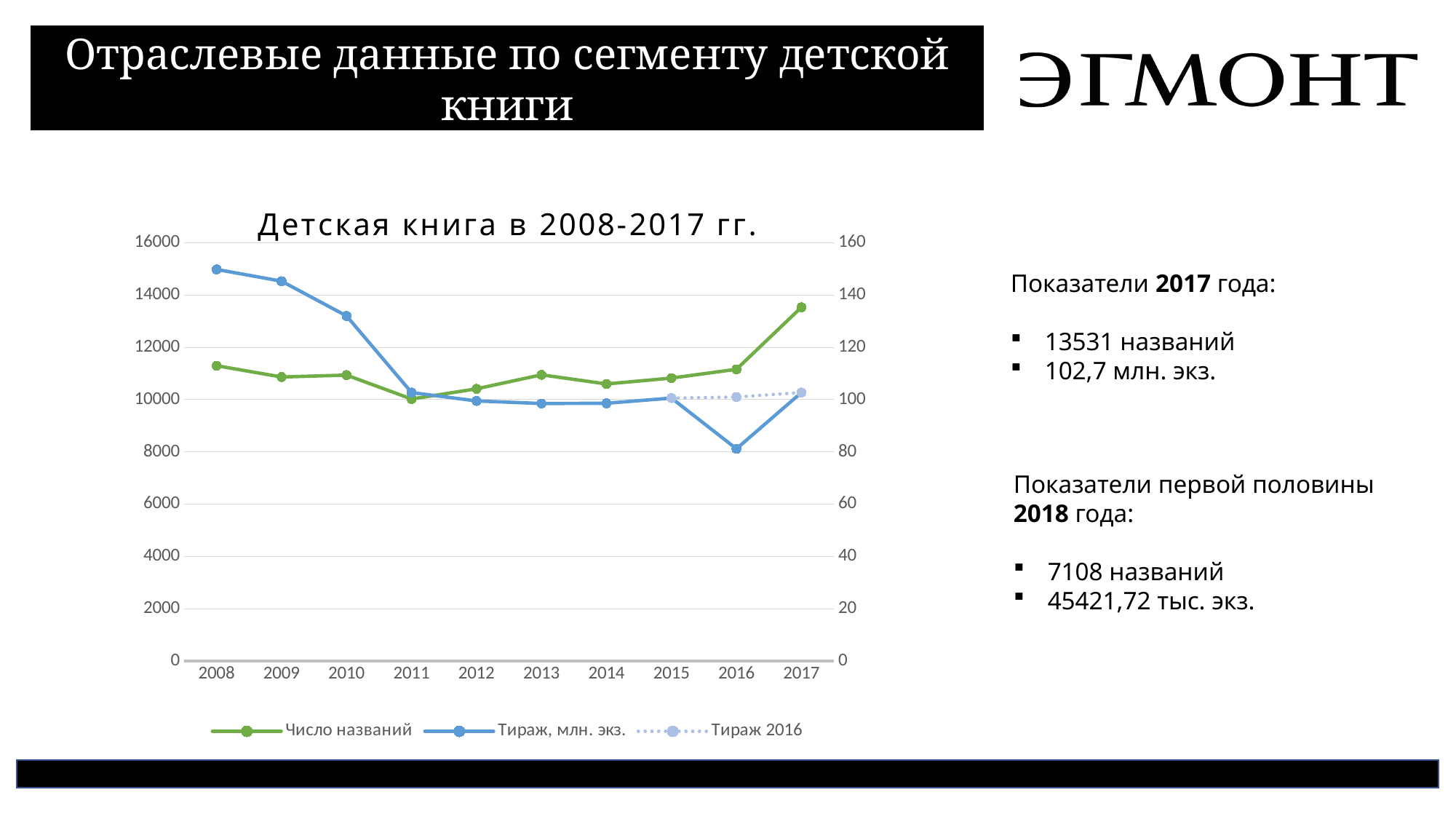
Does the value of 'Тираж, млн. экз.' rise or fall from 2008 to 2011? fall How many series does the chart legend list? 3 In which year is the value of 'Тираж, млн. экз.' lowest? 2016 What is the title of the chart? Детская книга в 2008-2017 гг. Is the value for 'Тираж, млн. экз.' in 2016 greater or less than 100? less How many years are plotted along the x axis of the chart? 10 Is the value for 'Число названий' in 2017 greater or less than 12000? greater What kind of chart is shown on the slide? line chart In which year is the value of 'Число названий' lowest? 2011 In which year is the value of 'Число названий' highest? 2017 In which year is the value of 'Тираж, млн. экз.' highest? 2008 Which is larger: 'Число названий' in 2008 or in 2009? 2008